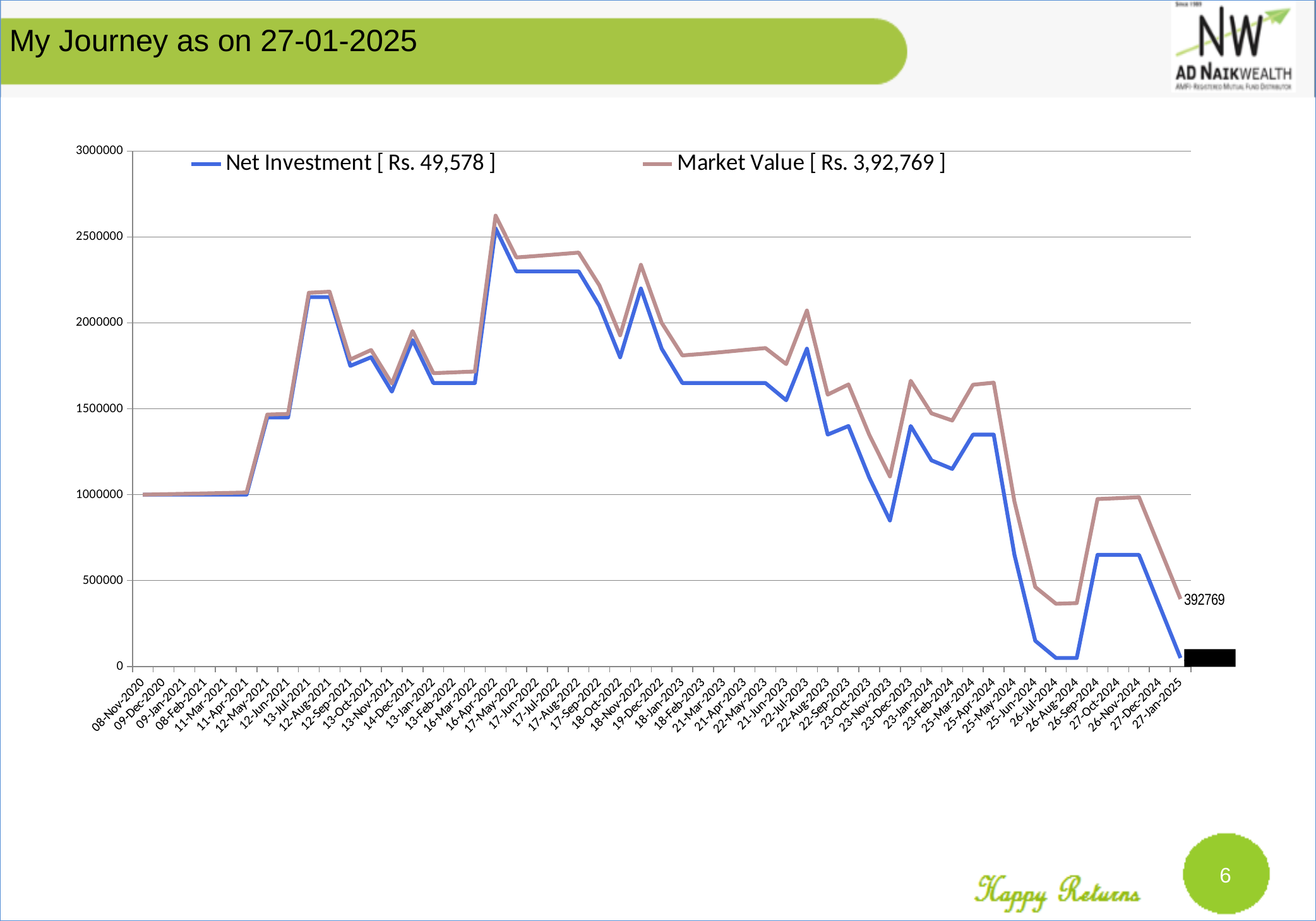
Which series is drawn in blue? Net Investment [ Rs. 49,578 ] How many dates are shown on the x axis? 51 Does the Net Investment line rise or fall between 25-Apr-2024 and 25-Jun-2024? fall Is the Net Investment at 08-Nov-2020 greater or less than 1500000? less How many series does the legend list? 2 On which date does the Market Value line reach its highest point? 16-Apr-2022 At 27-Jan-2025, which is larger, Market Value or Net Investment? Market Value What is the Market Value at 27-Jan-2025 according to the data label? 392769 What kind of chart is shown on the slide? line chart What value is shown in brackets in the legend entry for Market Value? Rs. 3,92,769 Is the Market Value at 26-Jul-2024 greater or less than 500000? less Is the Market Value at 16-Apr-2022 greater or less than 2500000? greater